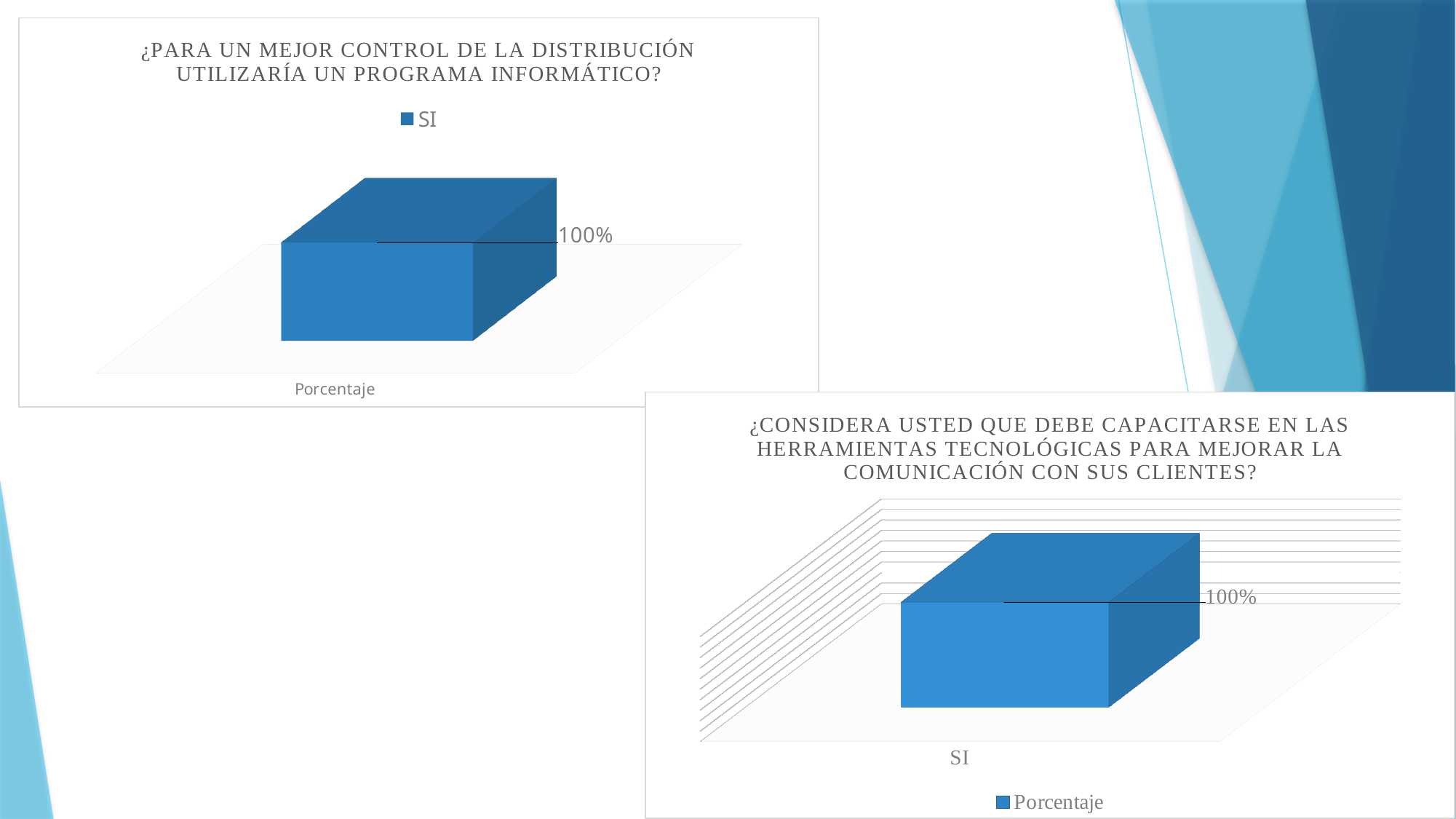
What is the category label on the x axis of the bottom-right chart? SI How many bars are plotted in the top-left chart? 1 In the bottom-right chart, what is the value of the Porcentaje bar for SI? 100% How many series does the legend of the bottom-right chart list? 1 How many bars are plotted in the bottom-right chart? 1 Is the value of the bar in the top-left chart equal to the value of the bar in the bottom-right chart? Yes, both are 100% How many series does the legend of the top-left chart list? 1 In the top-left chart, what value is shown for the SI series? 100% What kind of chart is the bottom-right chart? Bar chart What kind of chart is the top-left chart? Bar chart What is the legend entry of the top-left chart? SI